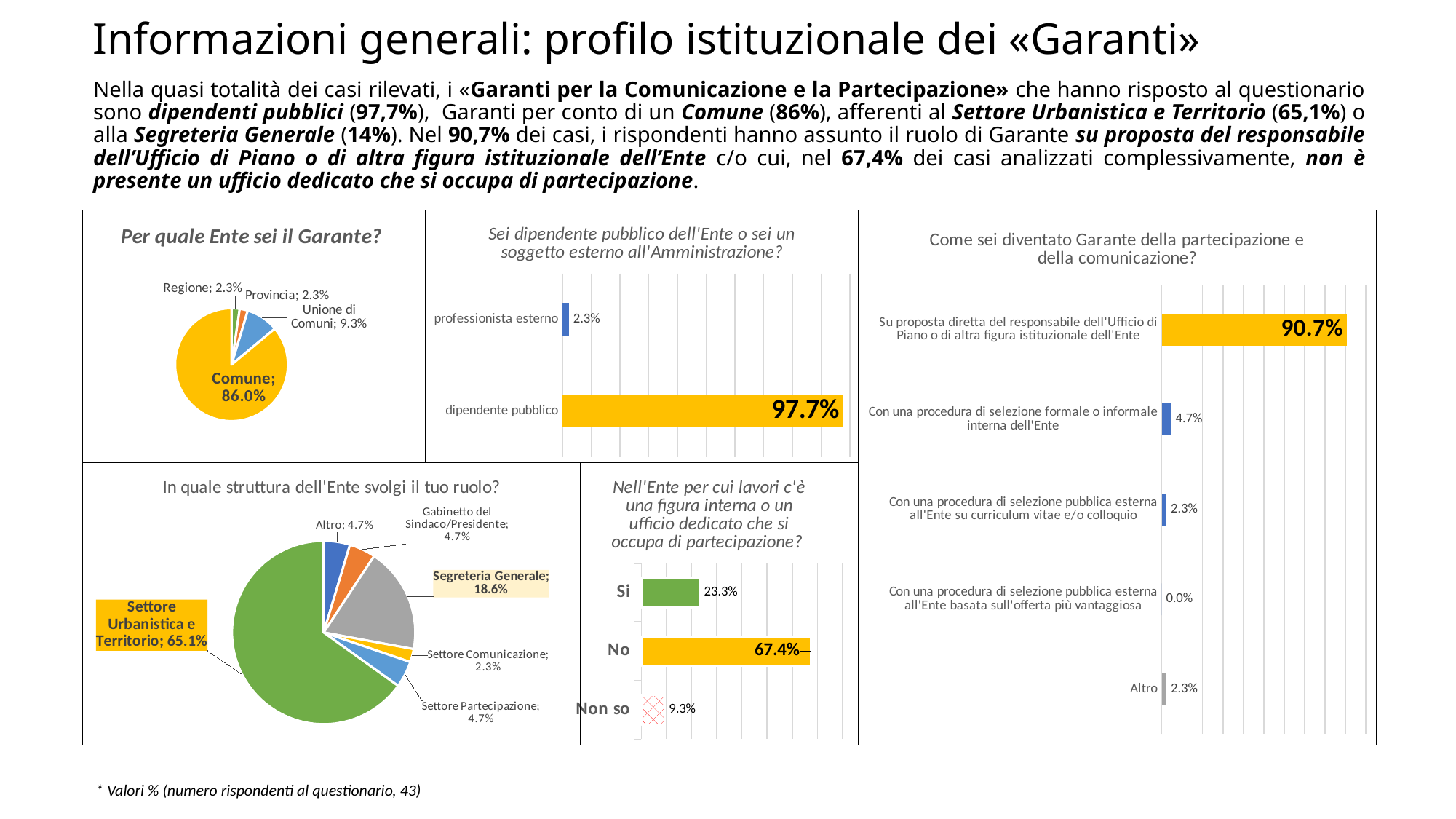
In the chart 'Come sei diventato Garante della partecipazione e della comunicazione?', which category has the lowest value? Con una procedura di selezione pubblica esterna all'Ente basata sull'offerta più vantaggiosa In the chart 'Per quale Ente sei il Garante?', what is the value for Unione di Comuni? 9.3% In the chart 'In quale struttura dell'Ente svolgi il tuo ruolo?', what is the value for Segreteria Generale? 18.6% In the chart 'Per quale Ente sei il Garante?', what is the value for Comune? 86.0% In the chart 'Sei dipendente pubblico dell'Ente o sei un soggetto esterno all'Amministrazione?', what is the value for dipendente pubblico? 97.7% In the chart 'Nell'Ente per cui lavori c'è una figura interna o un ufficio dedicato che si occupa di partecipazione?', which is larger, Si or No? No In the chart 'In quale struttura dell'Ente svolgi il tuo ruolo?', which category has the largest share? Settore Urbanistica e Territorio In the chart 'Sei dipendente pubblico dell'Ente o sei un soggetto esterno all'Amministrazione?', what is the difference between dipendente pubblico and professionista esterno? 95.4% How many categories are shown in the chart 'Come sei diventato Garante della partecipazione e della comunicazione?'? 5 What kind of chart is 'Come sei diventato Garante della partecipazione e della comunicazione?'? bar chart How many slices does the pie chart 'Per quale Ente sei il Garante?' have? 4 In the chart 'Come sei diventato Garante della partecipazione e della comunicazione?', what is the value for 'Con una procedura di selezione formale o informale interna dell'Ente'? 4.7%